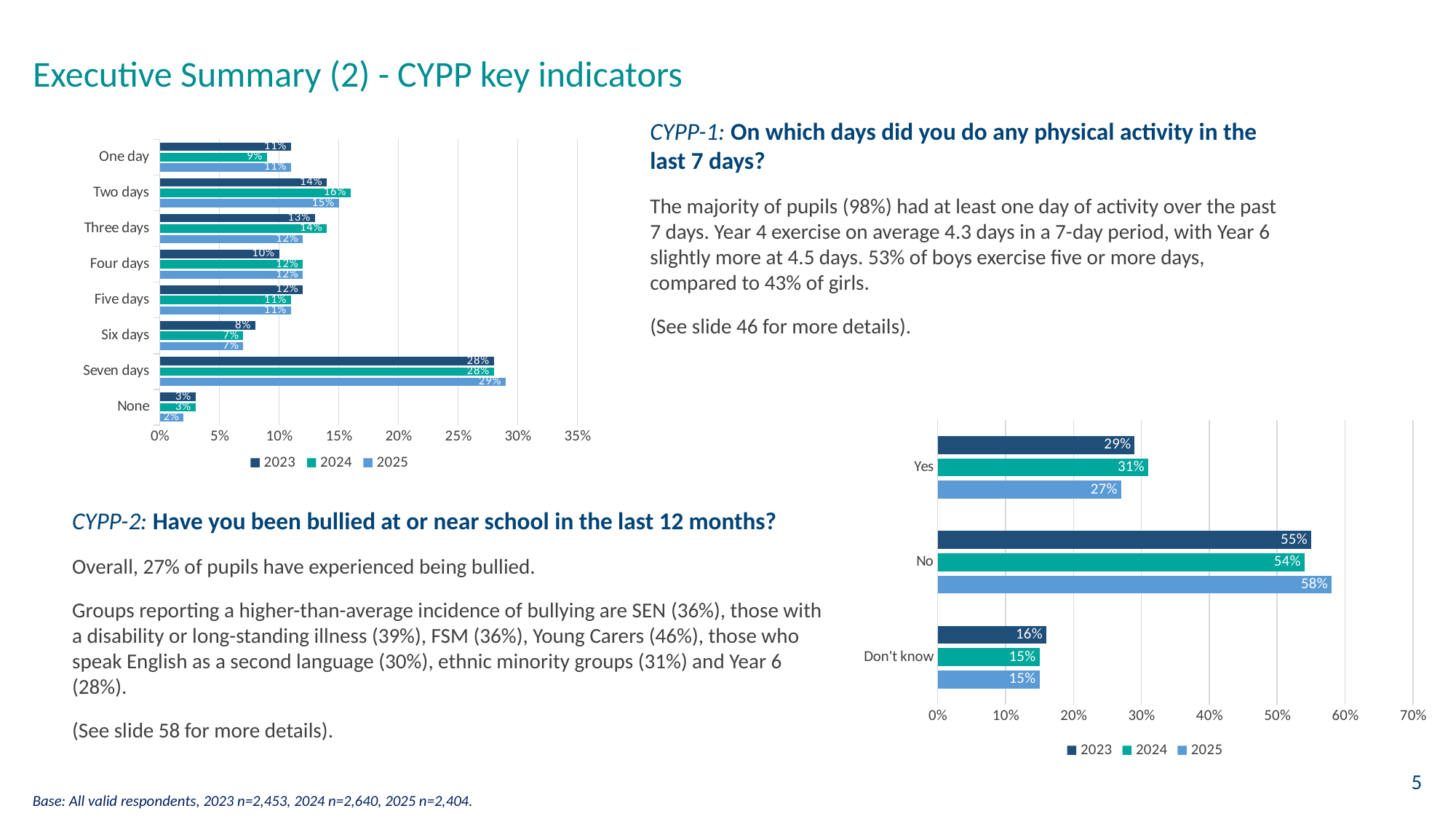
In the top-left chart, what is the 2025 value for "Seven days"? 29% In the bottom-right chart, what is the difference between the 2025 and 2023 values for "No"? 3% In the top-left chart, what is the 2024 value for "Two days"? 16% In the top-left chart, which category has the highest 2023 value? Seven days In the top-left chart, which category has the lowest 2025 value? None What kind of chart is the bottom-right chart? Bar chart How many series does the legend of the bottom-right chart list? 3 In the bottom-right chart, what is the 2025 value for "No"? 58% In the bottom-right chart, is the 2023 value for "Don't know" greater or less than 20%? less How many categories are shown on the y axis of the top-left chart? 8 In the bottom-right chart, which is larger for "Yes": the 2024 value or the 2025 value? 2024 In the bottom-right chart, what is the 2024 value for "Yes"? 31%